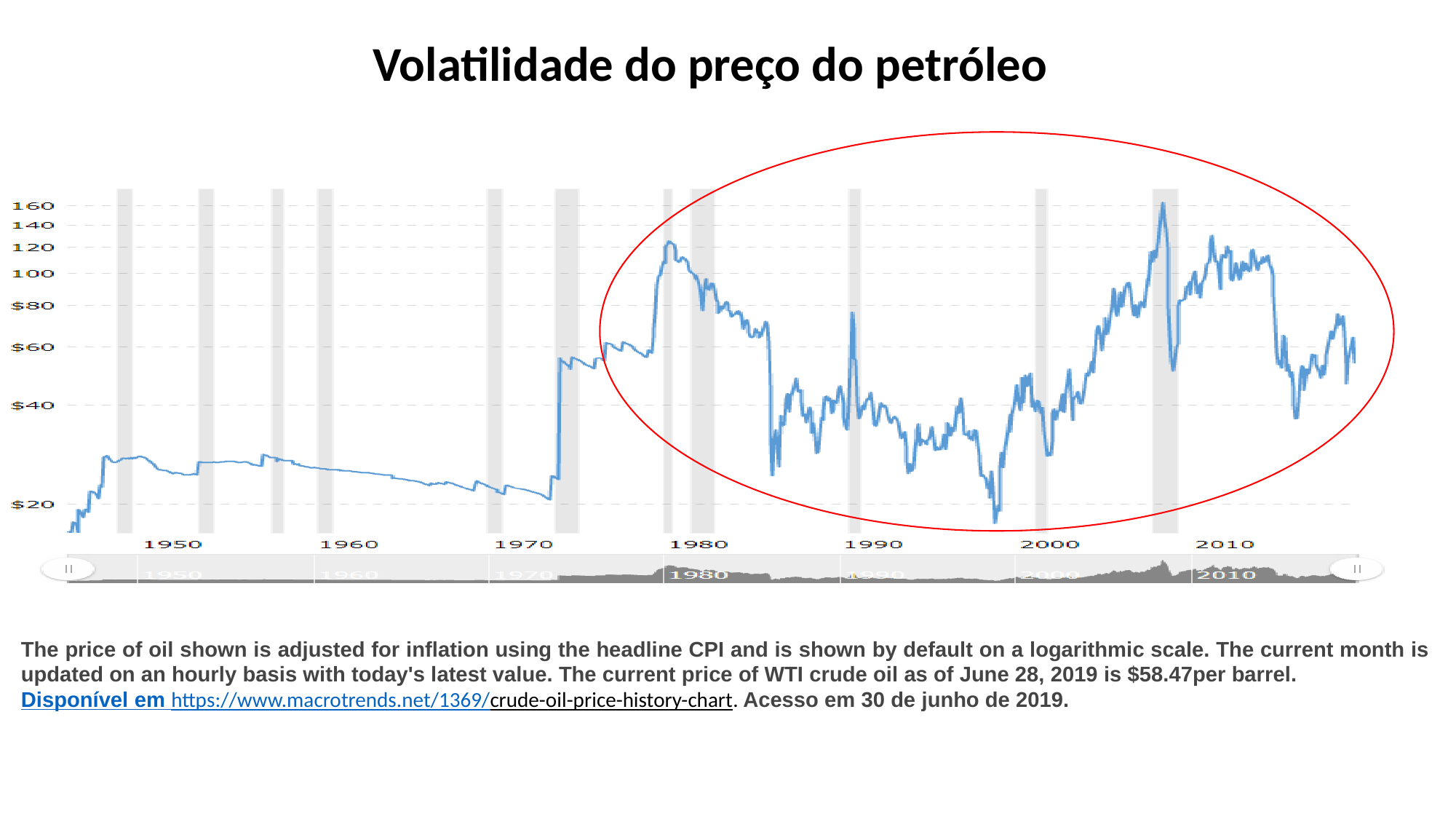
How many data series are plotted on the chart? 1 How many year labels are shown on the x axis of the chart? 7 Does the oil price generally rise or fall between 1950 and 1970? fall What kind of chart is shown on the slide? line chart According to the text below the chart, what kind of scale is the price shown on by default? logarithmic scale Is the highest peak of the oil price, reached between 2000 and 2010, greater or less than 140? greater Is the oil price around 1960 greater or less than $40? less Between which two x-axis year labels does the oil price reach its highest value? between 2000 and 2010 What is the title of the slide containing the chart? Volatilidade do preço do petróleo According to the text below the chart, what is the current price of WTI crude oil as of June 28, 2019? $58.47 Is the oil price around 1980 greater or less than $80? greater Which is larger, the oil price around 1980 or the oil price around 1990? around 1980